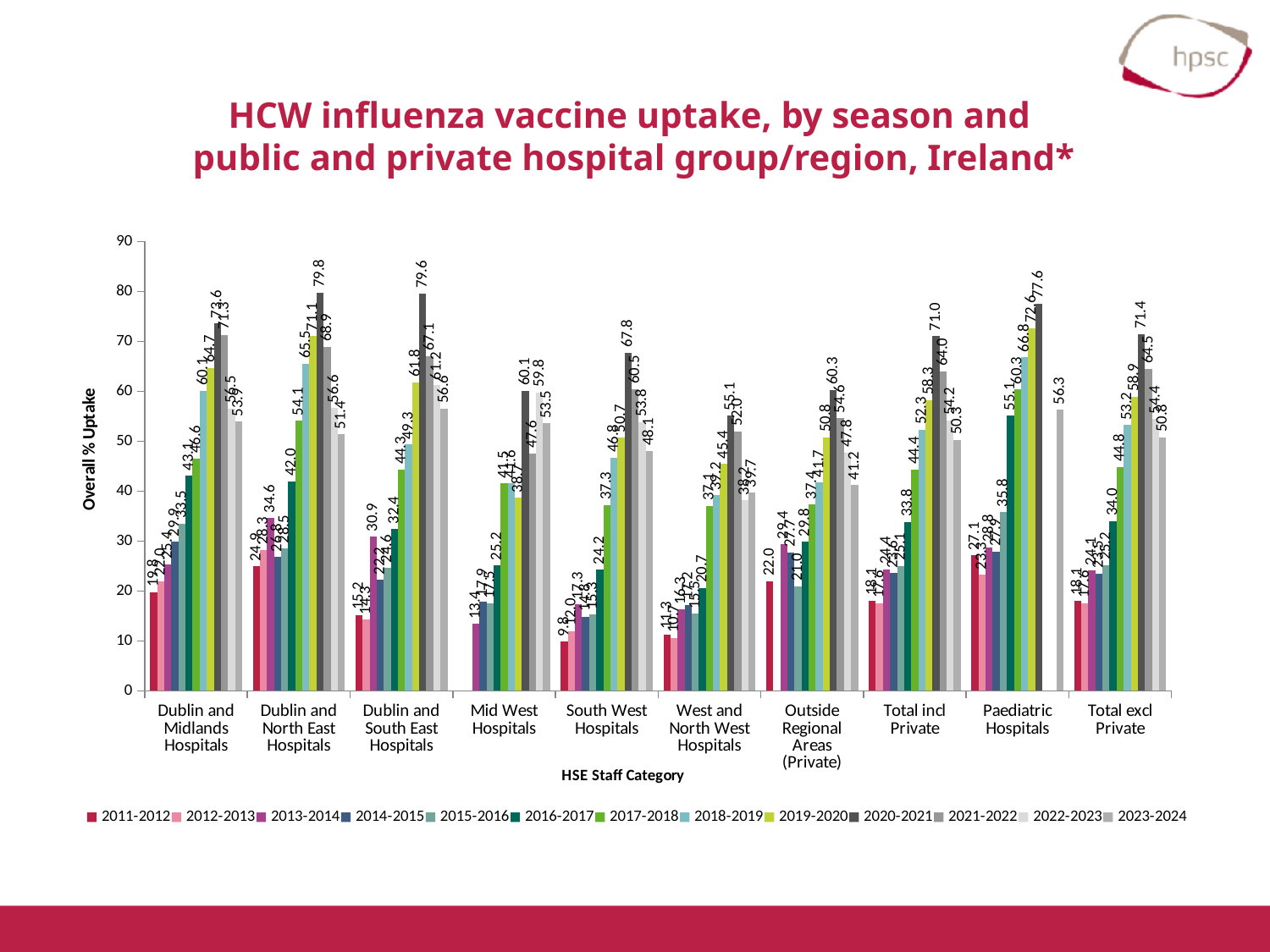
How many hospital group/region categories are shown on the x axis? 10 What was the 2020-2021 uptake for Total incl Private? 71.0 What was the 2020-2021 uptake for Dublin and Midlands Hospitals? 73.6 What is the label on the y axis? Overall % Uptake What was the 2020-2021 uptake for Dublin and North East Hospitals? 79.8 Which had the higher 2020-2021 uptake, South West Hospitals or Mid West Hospitals? South West Hospitals What type of chart is shown on the slide? Bar chart Is the 2011-2012 uptake for South West Hospitals greater or less than 10? less How many seasons (series) does the legend list? 13 What is the difference between the 2020-2021 uptake for Total excl Private and Total incl Private? 0.4 What was the 2011-2012 uptake for Outside Regional Areas (Private)? 22.0